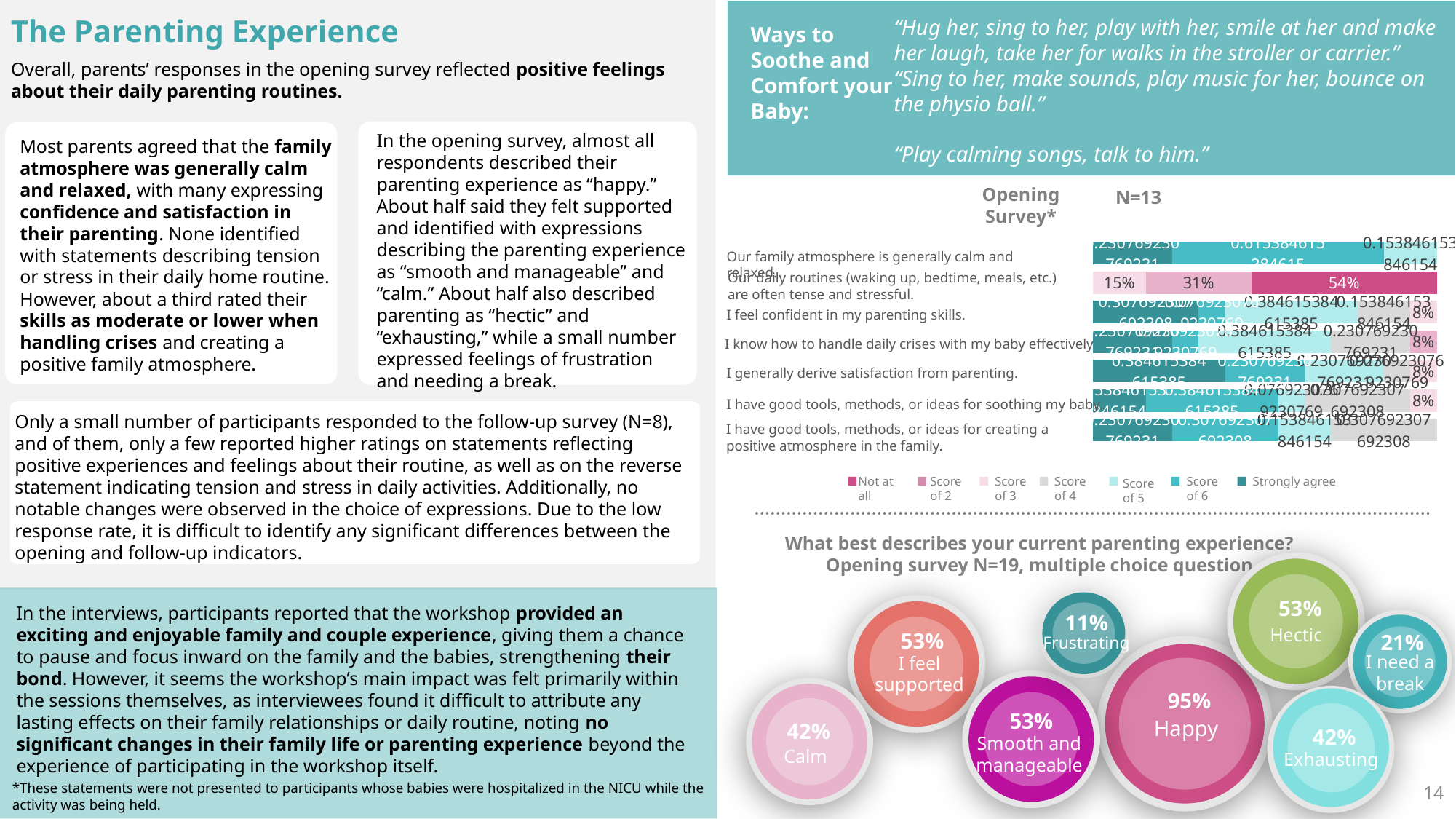
In the bubble chart 'What best describes your current parenting experience?', what is the difference in percentage points between 'Happy' and 'Calm'? 53 percentage points In the bubble chart 'What best describes your current parenting experience?', what percentage of respondents chose 'Happy'? 95% In the 'Opening Survey*' chart, what is the largest segment value shown for the statement 'Our daily routines (waking up, bedtime, meals, etc.) are often tense and stressful'? 54% In the bubble chart 'What best describes your current parenting experience?', which description has the highest percentage? Happy How many series does the legend of the 'Opening Survey*' stacked bar chart list? 7 In the bubble chart 'What best describes your current parenting experience?', which has a larger percentage, 'Hectic' or 'I need a break'? Hectic How many descriptions (bubbles) are shown in the chart 'What best describes your current parenting experience?'? 8 What sample size (N) is stated for the 'Opening Survey*' stacked bar chart? N=13 In the bubble chart 'What best describes your current parenting experience?', which description has the lowest percentage? Frustrating How many statements (categories) are plotted in the 'Opening Survey*' stacked bar chart? 7 In the bubble chart 'What best describes your current parenting experience?', what percentage chose 'Exhausting'? 42% In the bubble chart 'What best describes your current parenting experience?', what percentage chose 'Frustrating'? 11%